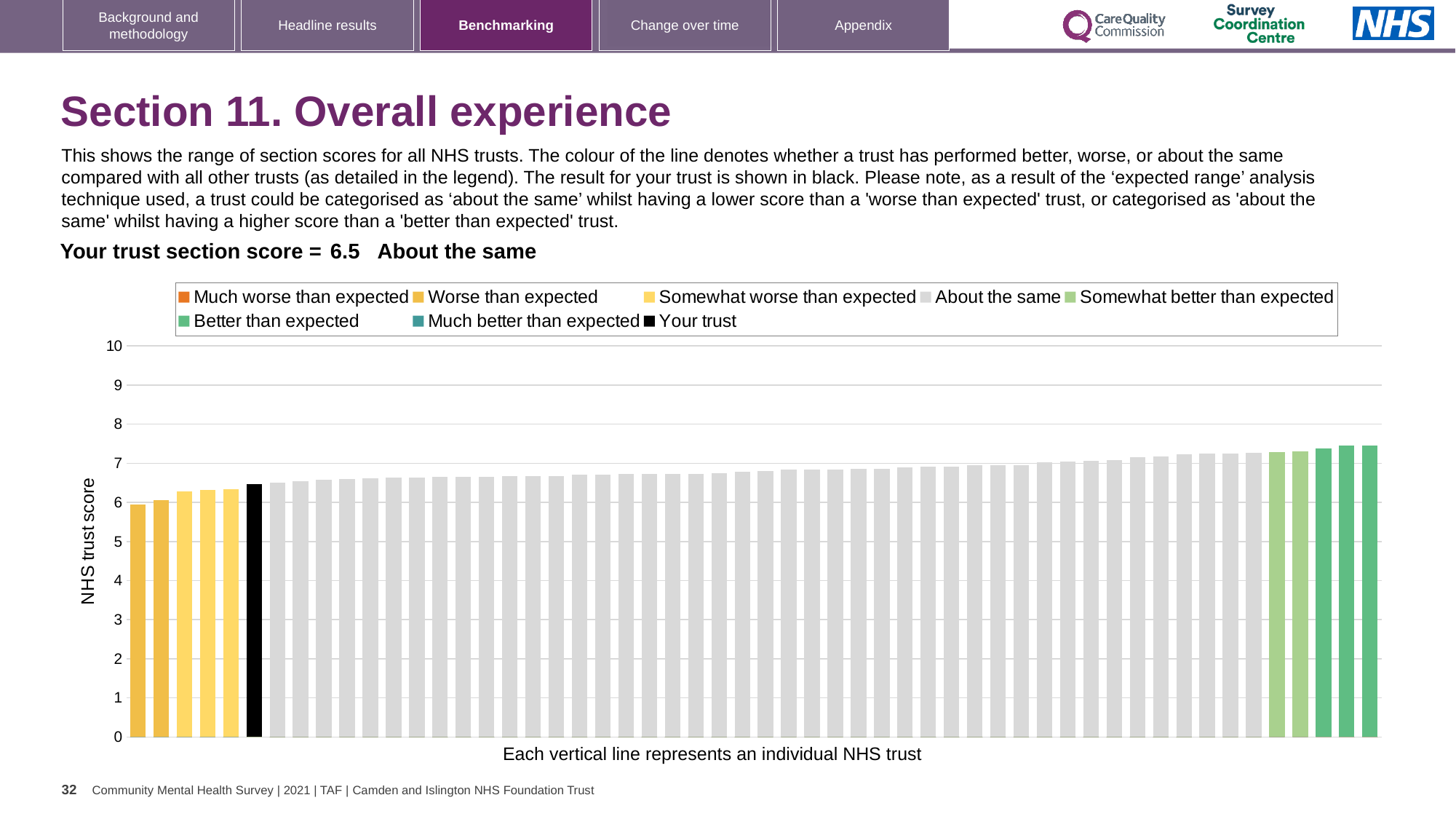
Is the value of the tallest bar greater or less than 7? greater How many entries does the chart legend list? 8 What is the section score for your trust shown on the slide? 6.5 Is the value for your trust (the black bar) greater or less than 7? less Do the bar values rise or fall from left to right along the x axis? rise What is the label on the vertical axis of the chart? NHS trust score Is the value for your trust (the black bar) greater or less than 6? greater What colour is used for the bar representing your trust? black Which category is your trust placed in for this section? About the same What kind of chart is shown on the slide? bar chart How many bars are to the left of the black bar? 5